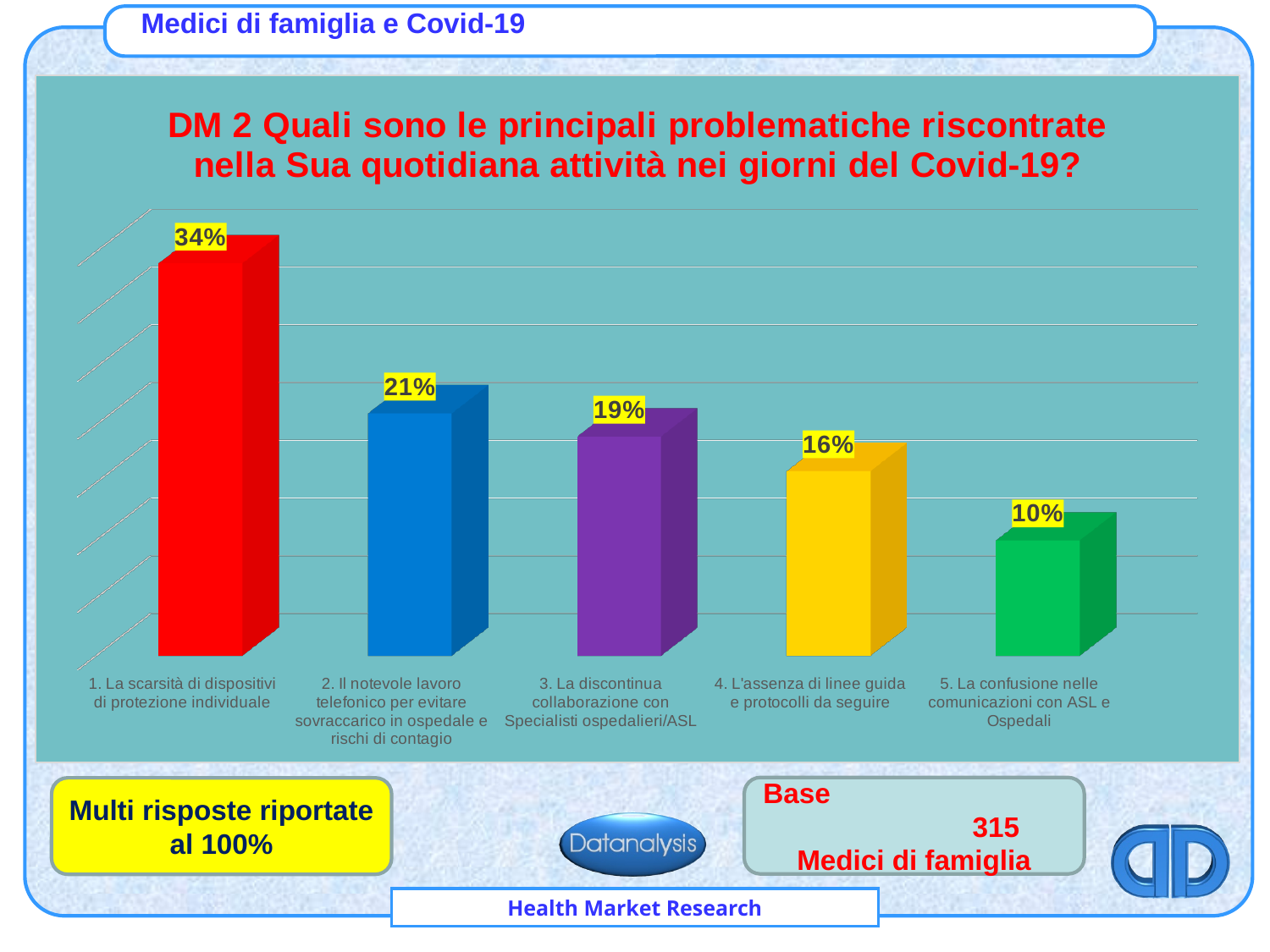
What colour is the bar for '5. La confusione nelle comunicazioni con ASL e Ospedali'? Green What percentage is shown for '3. La discontinua collaborazione con Specialisti ospedalieri/ASL'? 19% Which category has the lowest value? 5. La confusione nelle comunicazioni con ASL e Ospedali Which is larger, the value for category 2 or the value for category 3? 2. Il notevole lavoro telefonico per evitare sovraccarico in ospedale e rischi di contagio Do the values rise or fall from left to right across the categories? Fall What is the difference between the values for category 4 and category 5? 6% How many categories are plotted in the chart? 5 What is the difference between the values for category 1 and category 2? 13% Which category has the highest value? 1. La scarsità di dispositivi di protezione individuale What percentage is shown for '4. L'assenza di linee guida e protocolli da seguire'? 16% What kind of chart is shown on the slide? Bar chart What percentage is shown for '1. La scarsità di dispositivi di protezione individuale'? 34%